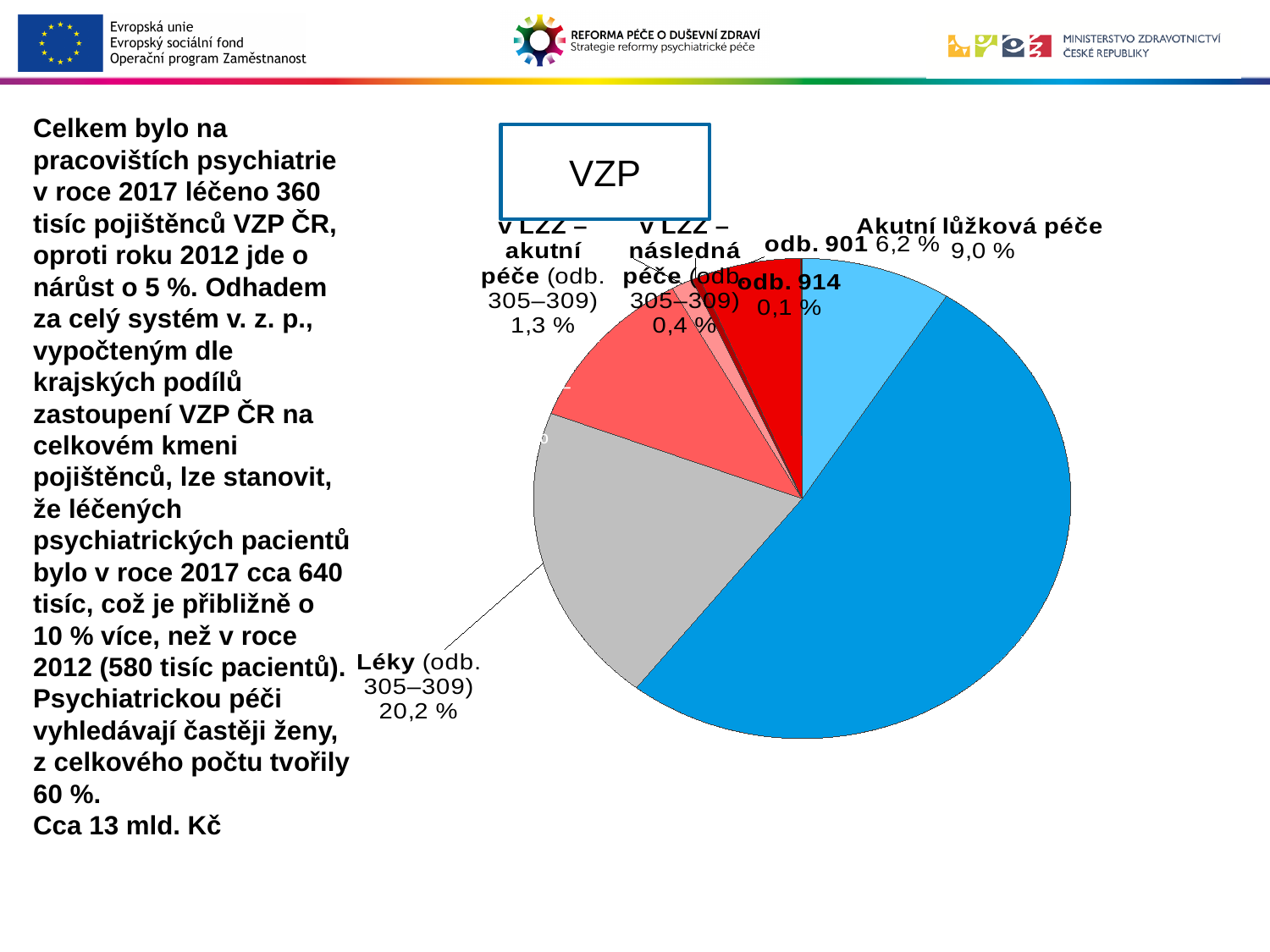
What share of the VZP pie chart is labelled for Léky (odb. 305–309)? 20,2 % By how many percentage points does the Léky (odb. 305–309) share exceed the Akutní lůžková péče share in the VZP pie chart? 11,2 % What share is labelled for V LZZ – akutní péče (odb. 305–309) in the VZP pie chart? 1,3 % What is the difference between the odb. 901 share and the V LZZ – akutní péče share in the VZP pie chart? 4,9 % What percentage is shown for odb. 914 in the VZP pie chart? 0,1 % What share does the Akutní lůžková péče slice have in the VZP pie chart? 9,0 % What type of chart is shown on the slide? Pie chart What share is labelled for V LZZ – následná péče (odb. 305–309) in the VZP pie chart? 0,4 % Which of the labelled slices in the VZP pie chart has the smallest share? odb. 914 Which is larger in the VZP pie chart: Léky (odb. 305–309) or Akutní lůžková péče? Léky (odb. 305–309) What is the title of the chart on the slide? VZP What percentage is shown for odb. 901 in the VZP pie chart? 6,2 %